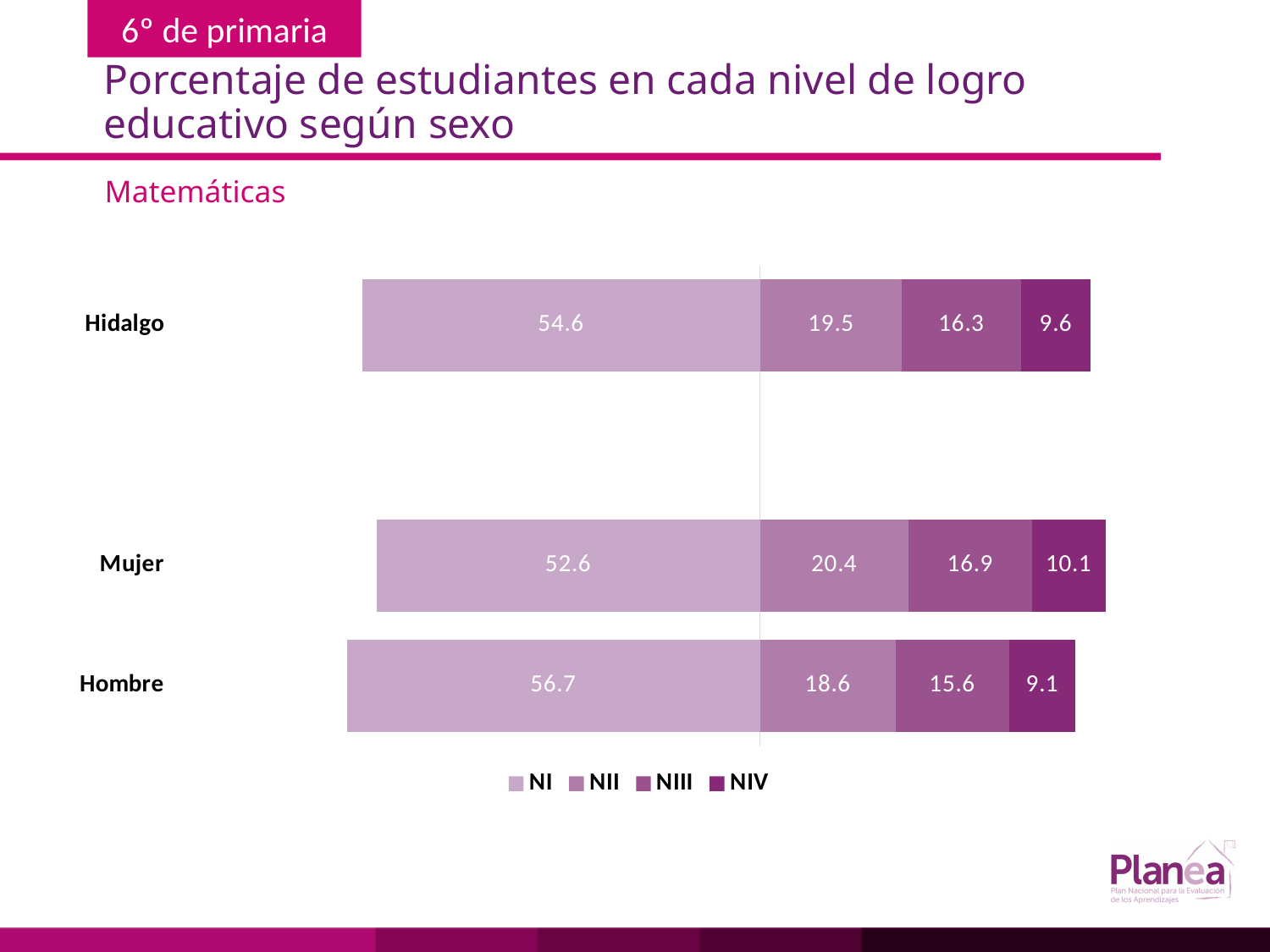
What is the NIV value for Mujer? 10.1 What kind of chart is shown? Stacked bar chart How many series does the legend list? 4 Which category has the lowest NIV value? Hombre What is the NI value for Hombre? 56.7 What is the difference between the NI values for Hombre and Mujer? 4.1 What is the NII value for Hidalgo? 19.5 What is the NIII value for Hombre? 15.6 How many categories are shown on the chart? 3 Which is larger, the NII value for Mujer or the NII value for Hombre? Mujer Which category has the highest NI value? Hombre What is the total of the stacked bar for Hidalgo? 100.0